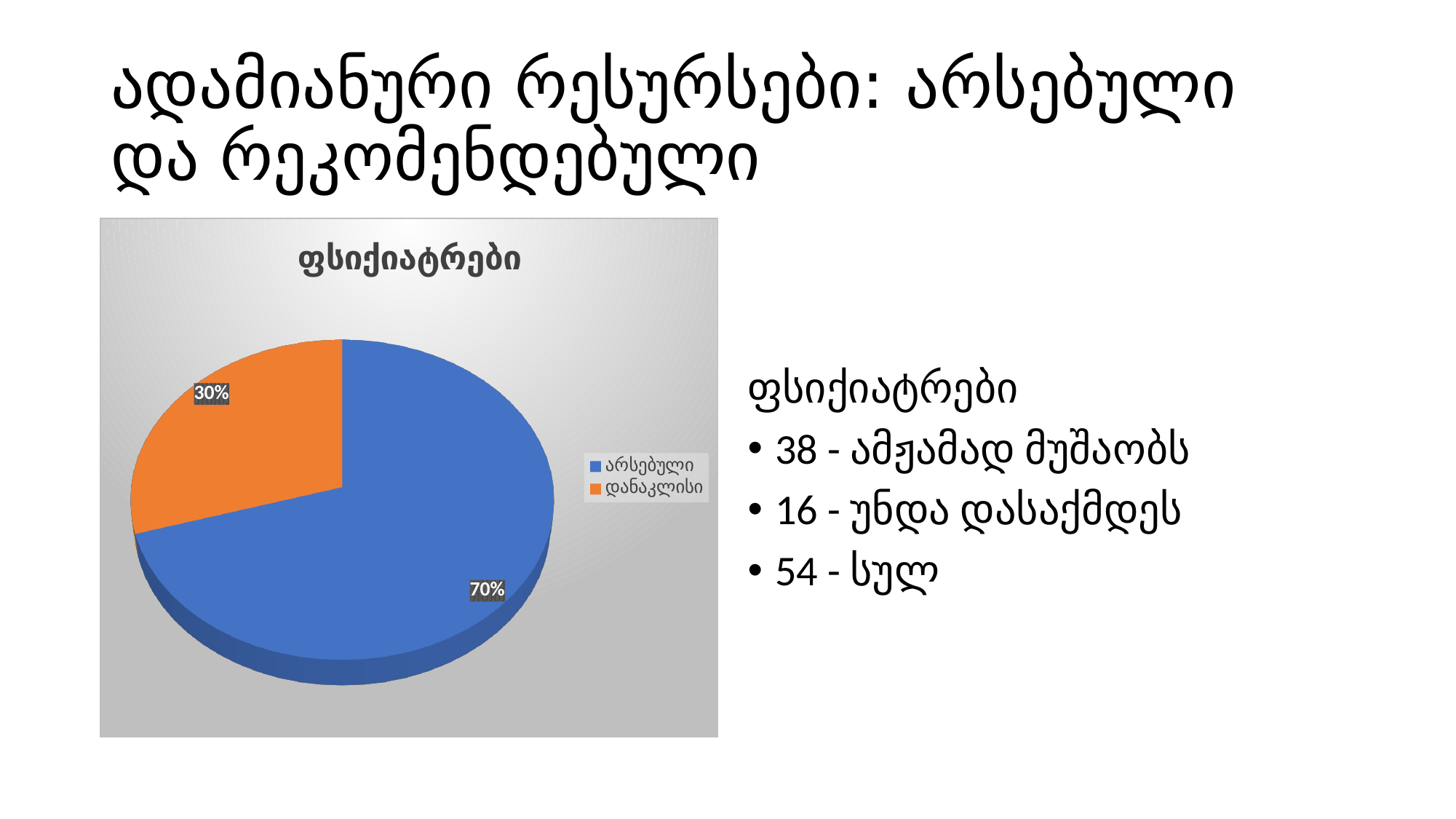
What kind of chart is shown on the slide? pie chart What is the difference in percentage points between the არსებული slice and the დანაკლისი slice? 40 percentage points How many entries does the legend list? 2 Which is larger, the slice for არსებული or the slice for დანაკლისი? არსებული What is the title of the chart? ფსიქიატრები How many slices does the pie chart have? 2 What colour is the slice for დანაკლისი? orange What share of the pie does the slice for დანაკლისი take? 30% Which slice of the pie is the smallest? დანაკლისი Which slice of the pie is the largest? არსებული What share of the pie does the slice for არსებული take? 70%